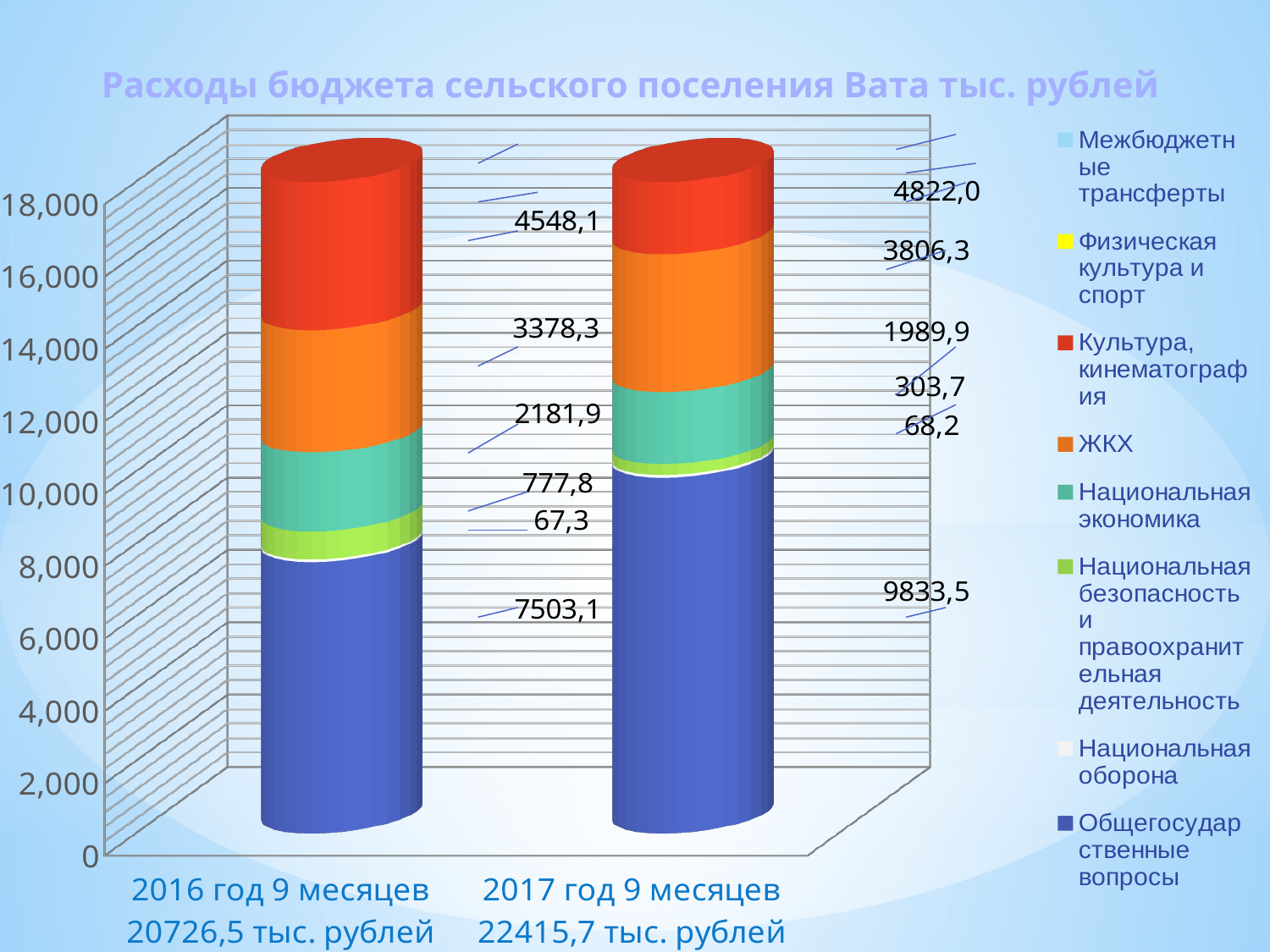
What is the value for Культура, кинематография in 2017 год 9 месяцев? 4822,0 By how much did Общегосударственные вопросы increase from 2016 to 2017? 2330,4 What is the value for Общегосударственные вопросы in 2017 год 9 месяцев? 9833,5 Which year has the larger value for Общегосударственные вопросы, 2016 or 2017? 2017 год 9 месяцев How many series does the legend list? 8 What is the difference between the ЖКХ values for 2017 and 2016? 428,0 What is the value for Общегосударственные вопросы in 2016 год 9 месяцев? 7503,1 How many bars (categories) are plotted on the chart? 2 What is the title of the chart? Расходы бюджета сельского поселения Вата тыс. рублей What is the value for ЖКХ in 2016 год 9 месяцев? 3378,3 What kind of chart is shown on the slide? Stacked bar chart